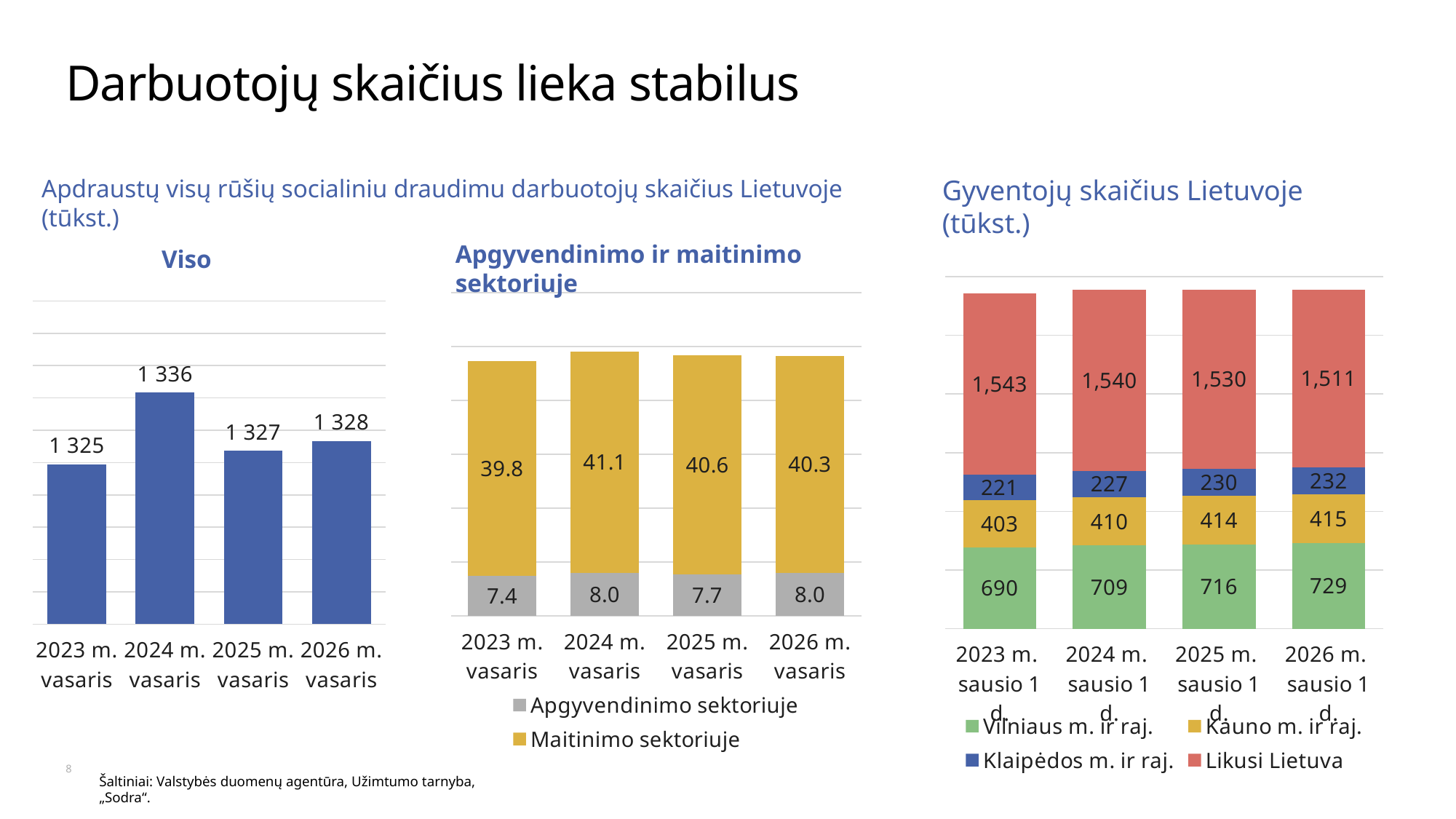
In the "Apgyvendinimo ir maitinimo sektoriuje" chart, what is the value for Apgyvendinimo sektoriuje in 2025 m. vasaris? 7.7 In the "Apgyvendinimo ir maitinimo sektoriuje" chart, what is the value for Maitinimo sektoriuje in 2024 m. vasaris? 41.1 In the "Gyventojų skaičius Lietuvoje (tūkst.)" chart, what is the value for Likusi Lietuva in 2023 m. sausio 1 d.? 1,543 In the "Viso" chart, which period has the lowest value? 2023 m. vasaris In the "Viso" chart, what is the difference between the 2024 m. vasaris and 2023 m. vasaris values? 11 How many series does the legend of the "Apgyvendinimo ir maitinimo sektoriuje" chart list? 2 What type of chart is the "Gyventojų skaičius Lietuvoje (tūkst.)" chart? stacked bar chart In the "Viso" chart, how many bars are plotted? 4 In the "Gyventojų skaičius Lietuvoje (tūkst.)" chart, does the Vilniaus m. ir raj. value rise or fall from 2023 to 2026? rise In the "Viso" chart, what is the value for 2024 m. vasaris? 1 336 In the "Gyventojų skaičius Lietuvoje (tūkst.)" chart, what is the value for Vilniaus m. ir raj. in 2026 m. sausio 1 d.? 729 In the "Apgyvendinimo ir maitinimo sektoriuje" chart, what is the total of the stacked bar for 2023 m. vasaris? 47.2